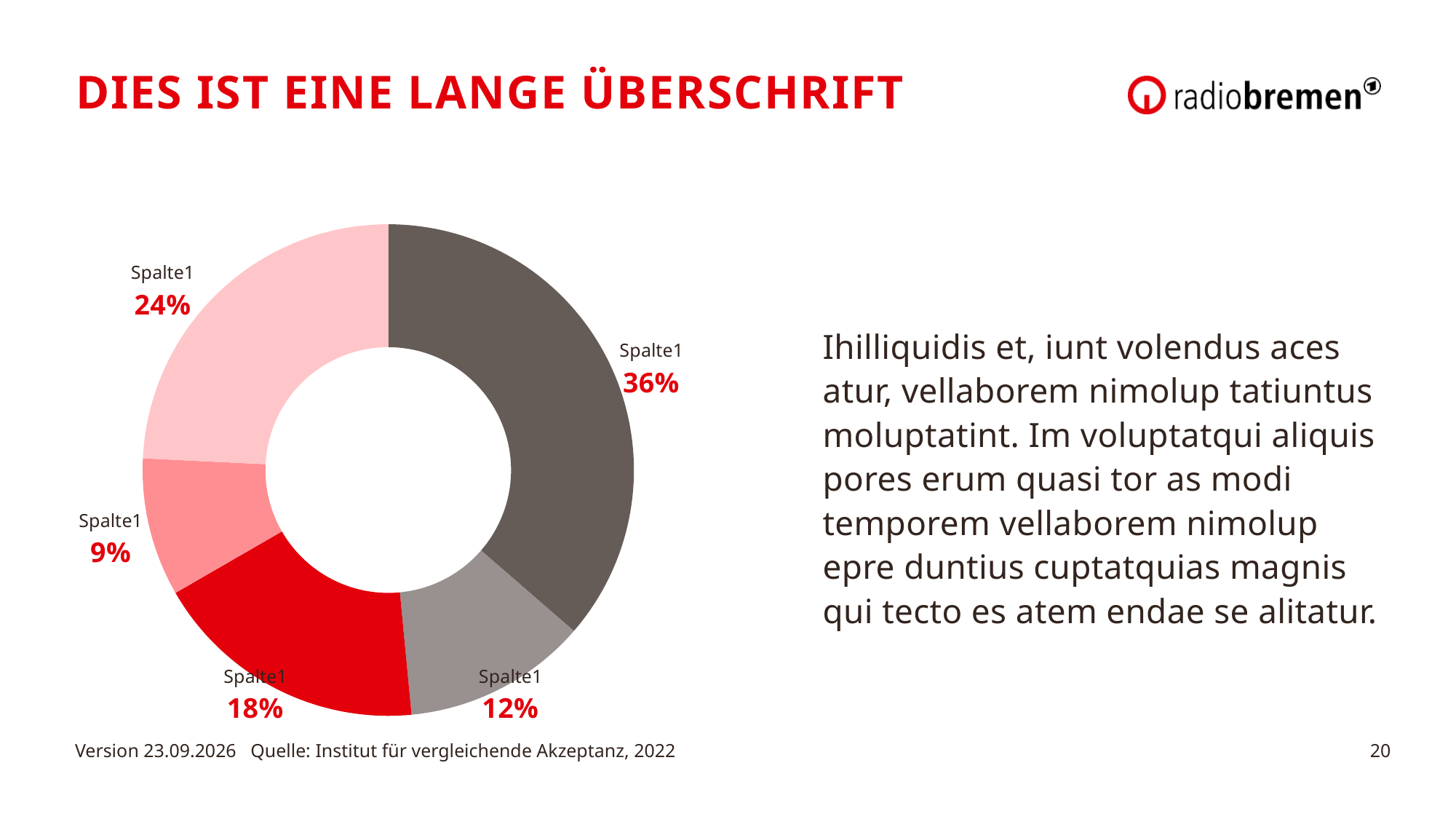
What is the value of the smallest slice in the doughnut chart? 9% What percentage is shown for the bright red slice at the bottom left of the doughnut chart? 18% Which slice is larger, the bright red slice or the light grey slice? the bright red slice (18%) What is the difference in percentage points between the largest slice (36%) and the light pink slice (24%)? 12 What is the value of the largest slice in the doughnut chart? 36% What colour is the largest slice of the doughnut chart? dark grey How many slices does the doughnut chart have? 5 What kind of chart is shown on the slide? doughnut chart What percentage is shown for the dark grey slice on the right of the doughnut chart? 36% What label is shown next to every slice of the doughnut chart? Spalte1 What percentage is shown for the light pink slice at the top left of the doughnut chart? 24% What percentage is shown for the light grey slice at the bottom right of the doughnut chart? 12%